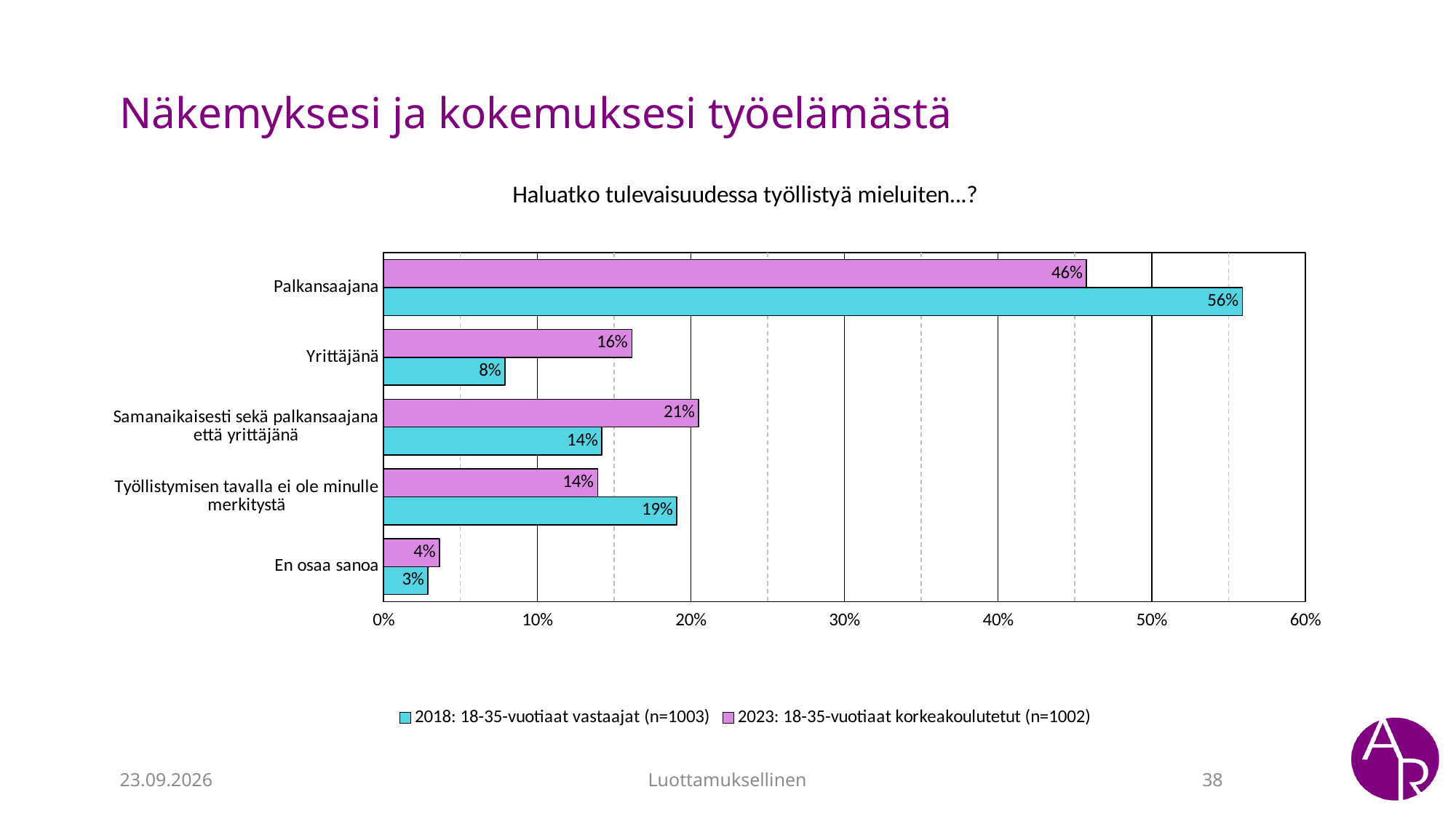
What kind of chart is shown on the slide? Bar chart How many categories are shown on the chart? 5 How many series does the legend list? 2 What is the value for En osaa sanoa in the 2018: 18-35-vuotiaat vastaajat (n=1003) series? 3% Is the 2023 value for Samanaikaisesti sekä palkansaajana että yrittäjänä greater or less than 20%? greater Which category has the highest value in the 2023: 18-35-vuotiaat korkeakoulutetut (n=1002) series? Palkansaajana What is the difference between the 2018 and 2023 values for Palkansaajana? 10% What is the value for Palkansaajana in the 2018: 18-35-vuotiaat vastaajat (n=1003) series? 56% Which series has the larger value for Työllistymisen tavalla ei ole minulle merkitystä: 2018 or 2023? 2018: 18-35-vuotiaat vastaajat (n=1003) What is the value for Yrittäjänä in the 2023: 18-35-vuotiaat korkeakoulutetut (n=1002) series? 16% What is the title of the chart? Haluatko tulevaisuudessa työllistyä mieluiten…? Which category has the lowest value in the 2018: 18-35-vuotiaat vastaajat (n=1003) series? En osaa sanoa